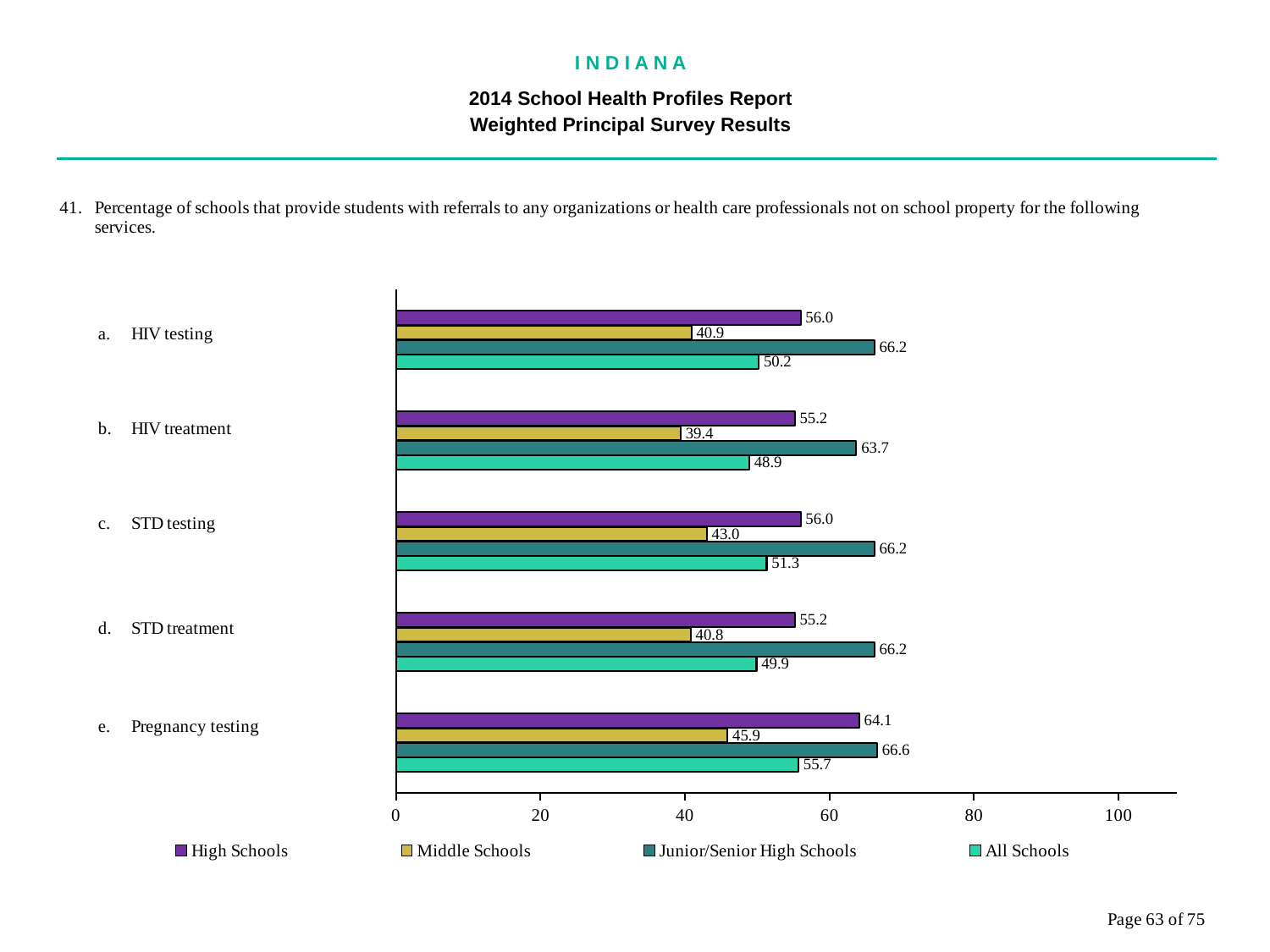
Which service has the lowest value for Middle Schools? HIV treatment How many series does the legend list? 4 Which is larger for STD testing: the High Schools value or the All Schools value? High Schools What is the difference between the Junior/Senior High Schools value and the Middle Schools value for HIV testing? 25.3 What is the value for Middle Schools for HIV treatment? 39.4 What kind of chart is shown on the slide? bar chart What is the value for Junior/Senior High Schools for STD treatment? 66.2 What is the value for High Schools for HIV testing? 56.0 Which service has the highest value for High Schools? Pregnancy testing What is the value for All Schools for Pregnancy testing? 55.7 How many services are listed on the chart? 5 Is the value for Middle Schools for Pregnancy testing greater or less than 60? less